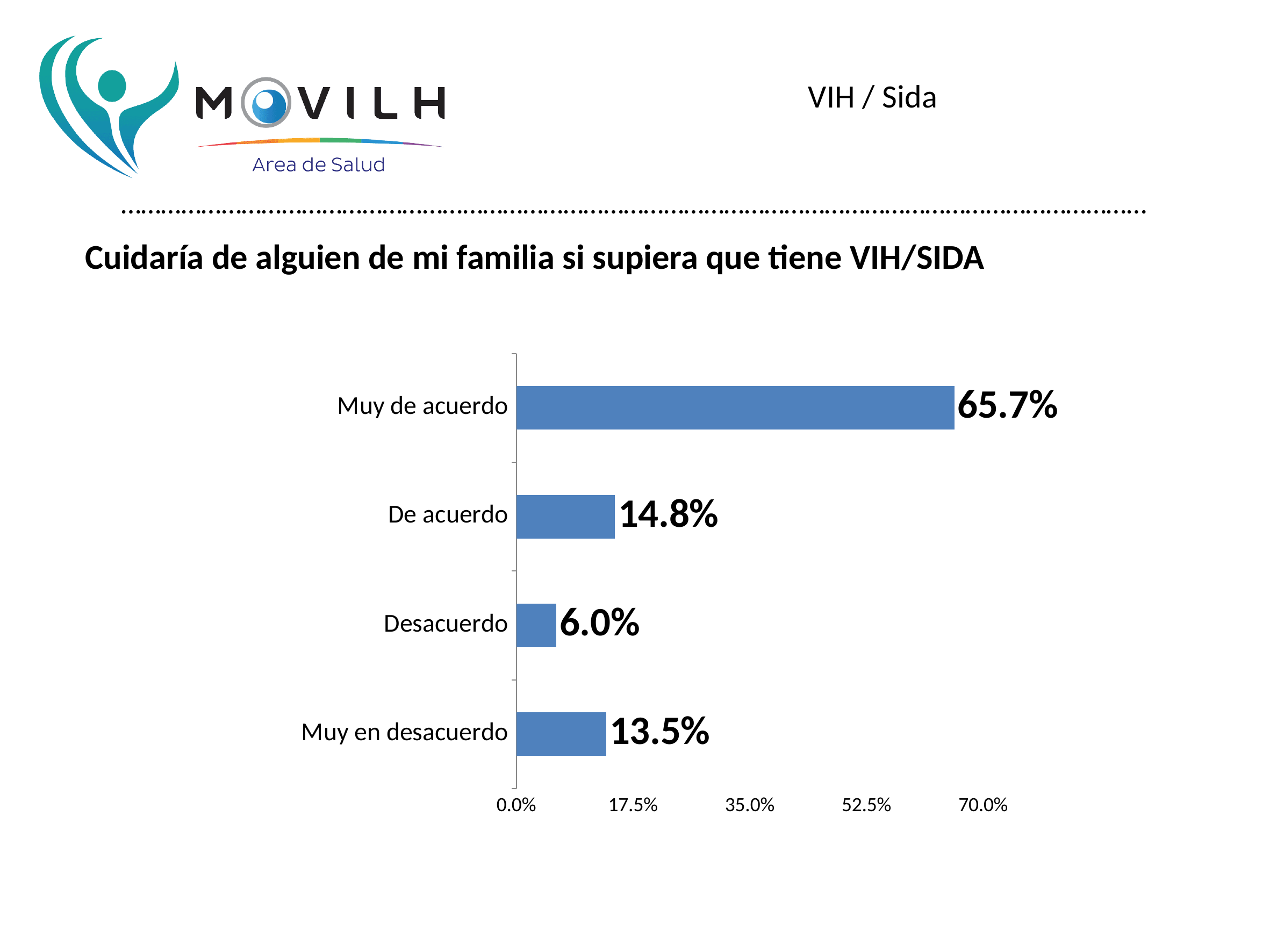
Which category has the highest value? Muy de acuerdo What is the value for "Desacuerdo"? 6.0% What is the value for "De acuerdo"? 14.8% Is the value for "Muy de acuerdo" greater or less than 52.5%? greater Which is larger, the value for "De acuerdo" or the value for "Muy en desacuerdo"? De acuerdo What is the difference between the values for "Muy de acuerdo" and "De acuerdo"? 50.9% What is the title of the chart? Cuidaría de alguien de mi familia si supiera que tiene VIH/SIDA What is the value for "Muy de acuerdo"? 65.7% How many categories are shown in the chart? 4 What kind of chart is shown on the slide? Bar chart Which category has the lowest value? Desacuerdo What is the value for "Muy en desacuerdo"? 13.5%